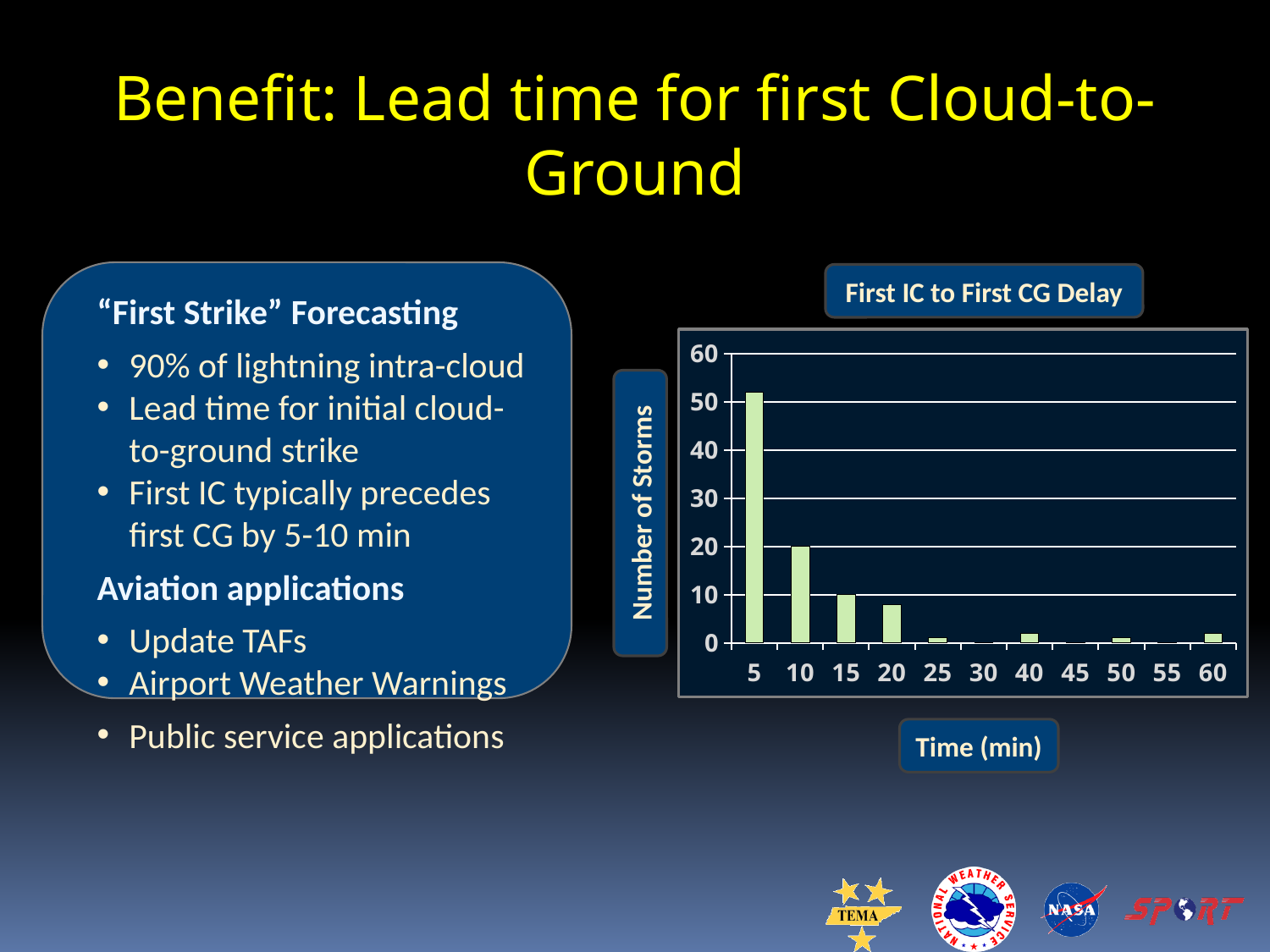
What is the label of the vertical axis of the chart? Number of Storms Is the number of storms for the 5 min category greater or less than 40? greater Which has more storms, the 15 min category or the 25 min category? 15 Which time category has the highest number of storms? 5 How many time categories are shown on the x axis of the chart? 11 What kind of chart is shown on the slide? bar chart Do the number of storms generally rise or fall as time increases along the x axis? fall What is the title of the chart? First IC to First CG Delay Is the number of storms for the 25 min category greater or less than 10? less Which has more storms, the 5 min category or the 10 min category? 5 Which has more storms, the 10 min category or the 20 min category? 10 Is the number of storms for the 20 min category greater or less than 10? less